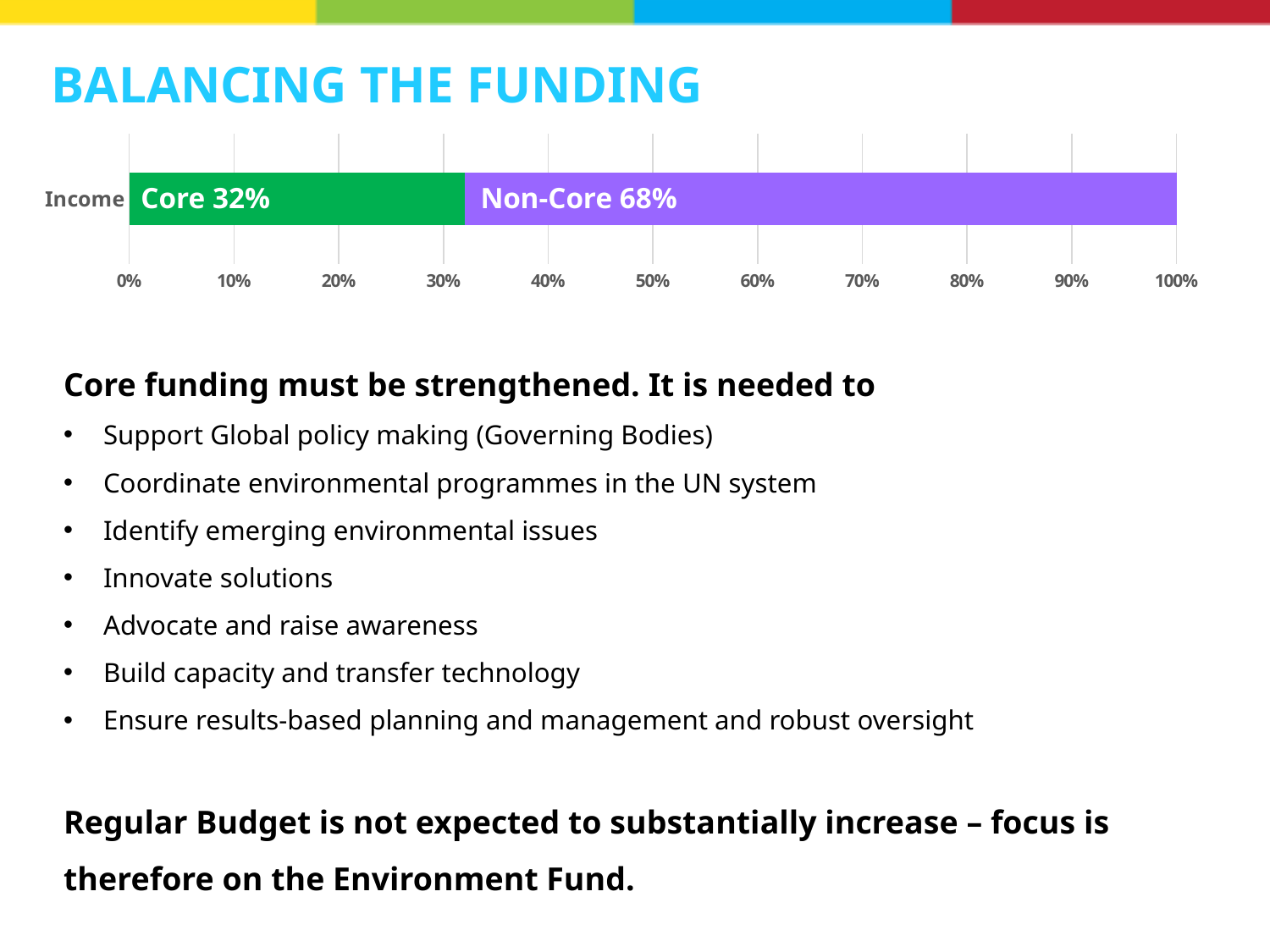
What is the label of the category on the vertical axis of the chart? Income What is the total of the Core and Non-Core segments of the Income bar? 100% Is the Core share of Income greater or less than 40%? less What share of Income is Non-Core? 68% What colour is the Non-Core segment of the bar? Purple Which segment of the Income bar is the smallest? Core Which segment of the Income bar is larger, Core or Non-Core? Non-Core How many segments make up the Income bar? 2 Is the Non-Core share of Income greater or less than 60%? greater What kind of chart is shown on the slide? Stacked horizontal bar chart What is the difference in percentage points between the Non-Core and Core shares of Income? 36 What share of Income is Core? 32%